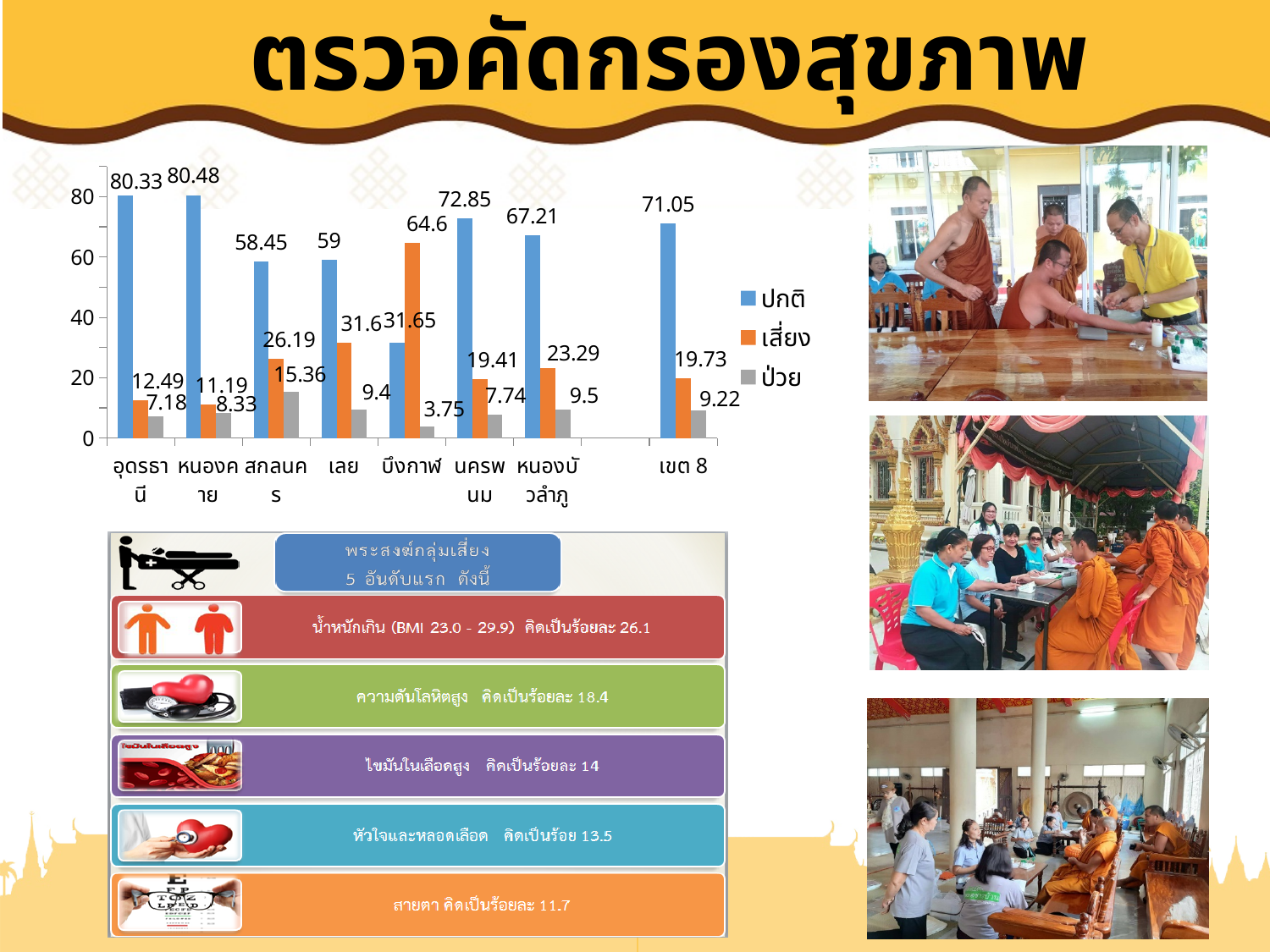
How many categories are shown on the x axis of the chart? 8 What is the ปกติ value for เขต 8? 71.05 What kind of chart is shown on the slide? bar chart What is the ปกติ value for นครพนม? 72.85 What is the ป่วย value for สกลนคร? 15.36 What is the เสี่ยง value for บึงกาฬ? 64.6 Which is larger: the เสี่ยง value for เลย or the เสี่ยง value for หนองบัวลำภู? เลย Which category has the highest เสี่ยง value? บึงกาฬ Which category has the lowest ป่วย value? บึงกาฬ How many series does the chart legend list? 3 Is the ปกติ value for บึงกาฬ greater or less than 40? less What is the difference between the ปกติ value for อุดรธานี and the ปกติ value for สกลนคร? 21.88